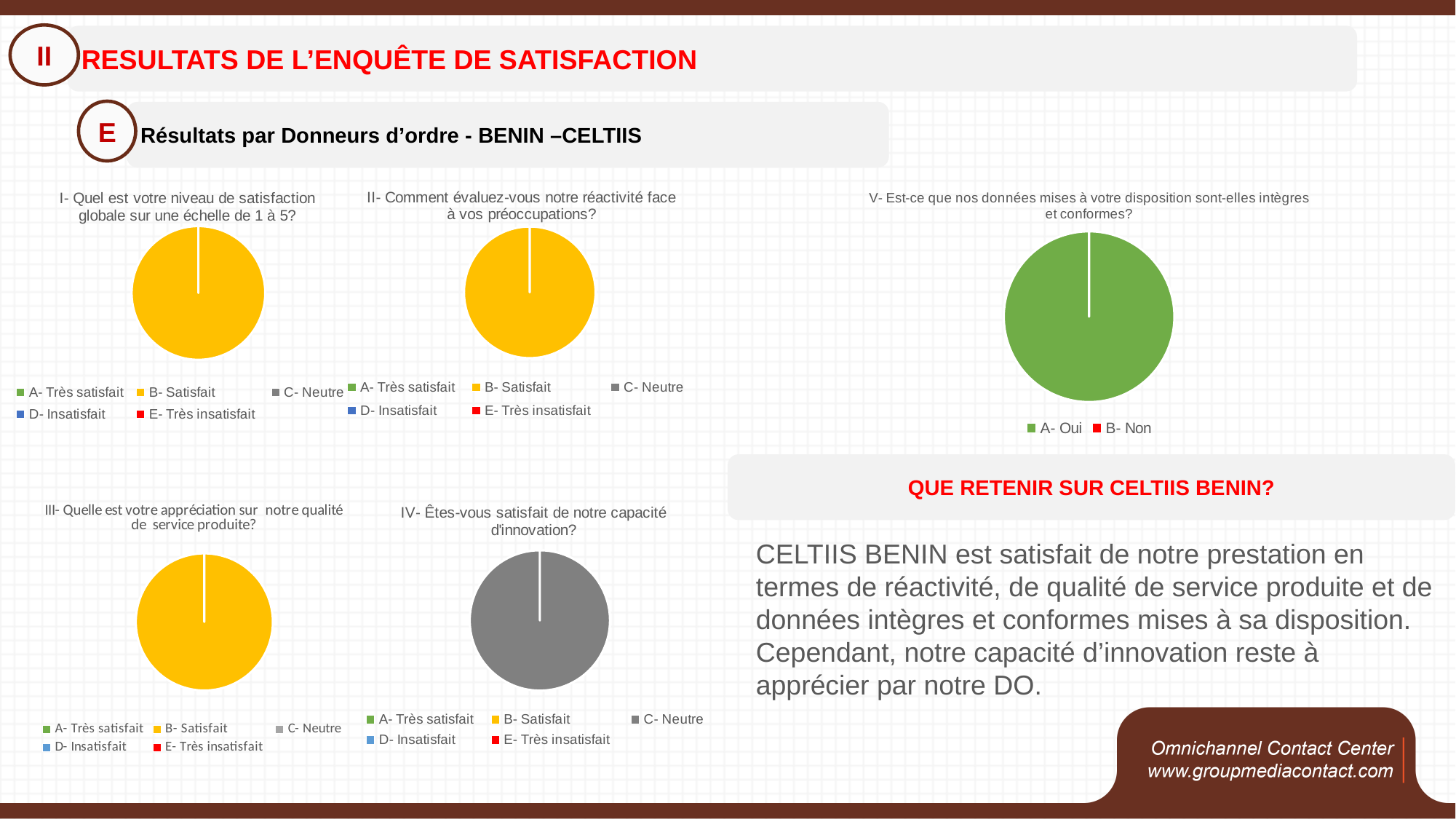
How many charts are shown on the slide? 5 In the chart "IV- Êtes-vous satisfait de notre capacité d'innovation?", is the slice for "C- Neutre" larger or smaller than the slice for "B- Satisfait"? Larger In the chart "V- Est-ce que nos données mises à votre disposition sont-elles intègres et conformes?", which category has the largest slice? A- Oui How many entries does the legend of the chart "IV- Êtes-vous satisfait de notre capacité d'innovation?" list? 5 What kind of chart is used for "I- Quel est votre niveau de satisfaction globale sur une échelle de 1 à 5?"? Pie chart In the chart "III- Quelle est votre appréciation sur notre qualité de service produite?", which category has the largest slice? B- Satisfait What colour is the pie in the chart "V- Est-ce que nos données mises à votre disposition sont-elles intègres et conformes?"? Green What colour represents "E- Très insatisfait" in the legend of the chart "I- Quel est votre niveau de satisfaction globale sur une échelle de 1 à 5?"? Red How many entries does the legend of the chart "V- Est-ce que nos données mises à votre disposition sont-elles intègres et conformes?" list? 2 In the chart "II- Comment évaluez-vous notre réactivité face à vos préoccupations?", which category has the largest slice? B- Satisfait